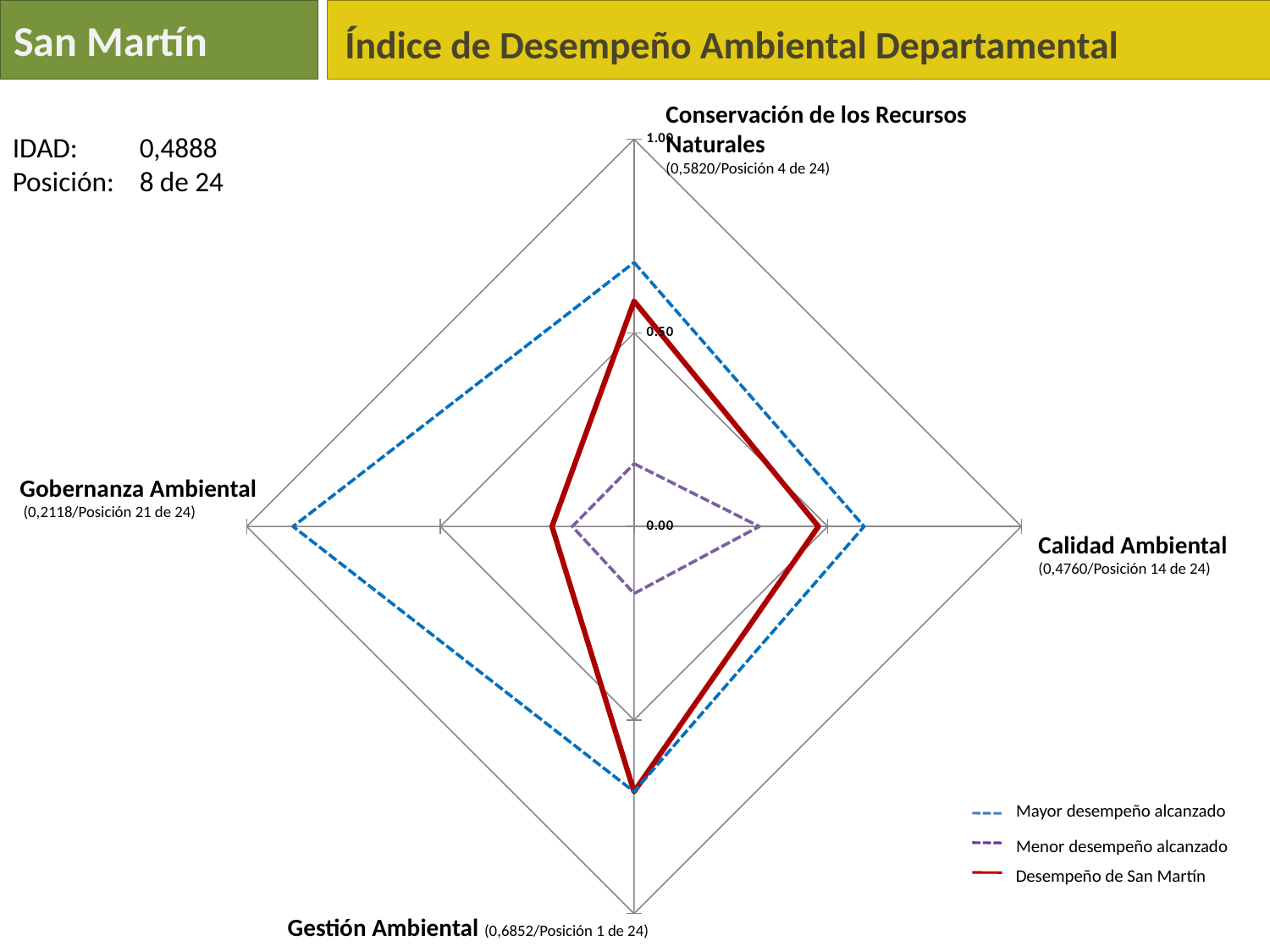
What is San Martín's value for Conservación de los Recursos Naturales? 0,5820 What is the difference between San Martín's values for Gestión Ambiental and Gobernanza Ambiental? 0,4734 What is San Martín's value for Gobernanza Ambiental? 0,2118 In which category does San Martín have its lowest value? Gobernanza Ambiental Which legend entry is drawn as a solid red line? Desempeño de San Martín What type of chart is shown on the slide? Radar chart How many series does the legend list? 3 How many axes (categories) does the radar chart have? 4 Which is larger for San Martín: Conservación de los Recursos Naturales or Calidad Ambiental? Conservación de los Recursos Naturales In which category does San Martín have its highest value? Gestión Ambiental Is San Martín's value for Gobernanza Ambiental greater or less than 0.50? less What is San Martín's value for Gestión Ambiental? 0,6852